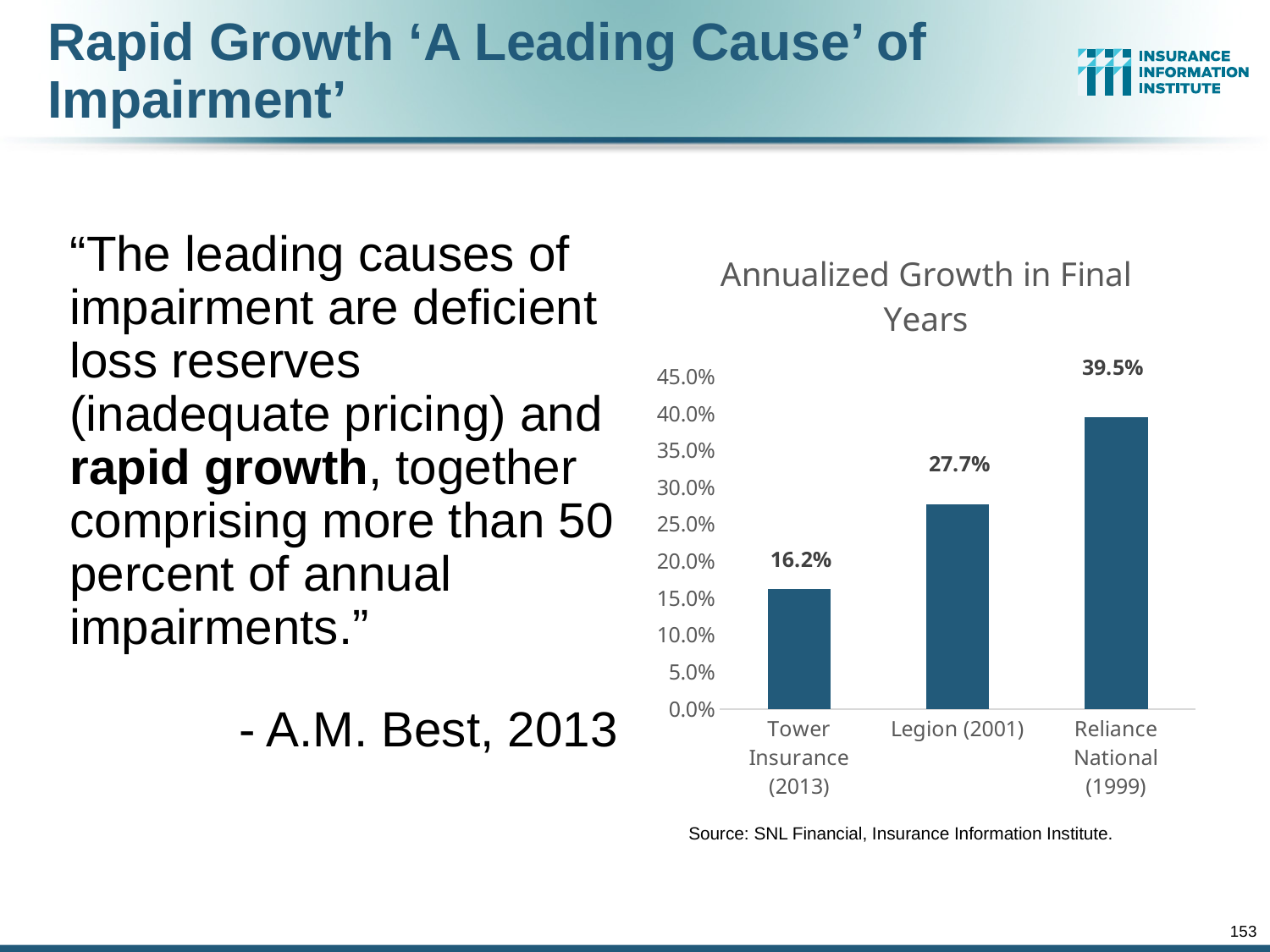
Is the annualized growth for Legion (2001) greater or less than 25.0%? greater Which company has the lowest annualized growth in final years? Tower Insurance (2013) What is the title of the chart on the slide? Annualized Growth in Final Years Which has a higher annualized growth in final years, Legion (2001) or Tower Insurance (2013)? Legion (2001) What is the annualized growth in final years for Tower Insurance (2013)? 16.2% What is the annualized growth in final years for Legion (2001)? 27.7% Which company has the highest annualized growth in final years? Reliance National (1999) What is the difference in annualized growth between Legion (2001) and Tower Insurance (2013)? 11.5% What is the difference in annualized growth between Reliance National (1999) and Tower Insurance (2013)? 23.3% How many companies are shown in the chart? 3 What type of chart is used to show annualized growth in final years? Bar chart What is the annualized growth in final years for Reliance National (1999)? 39.5%